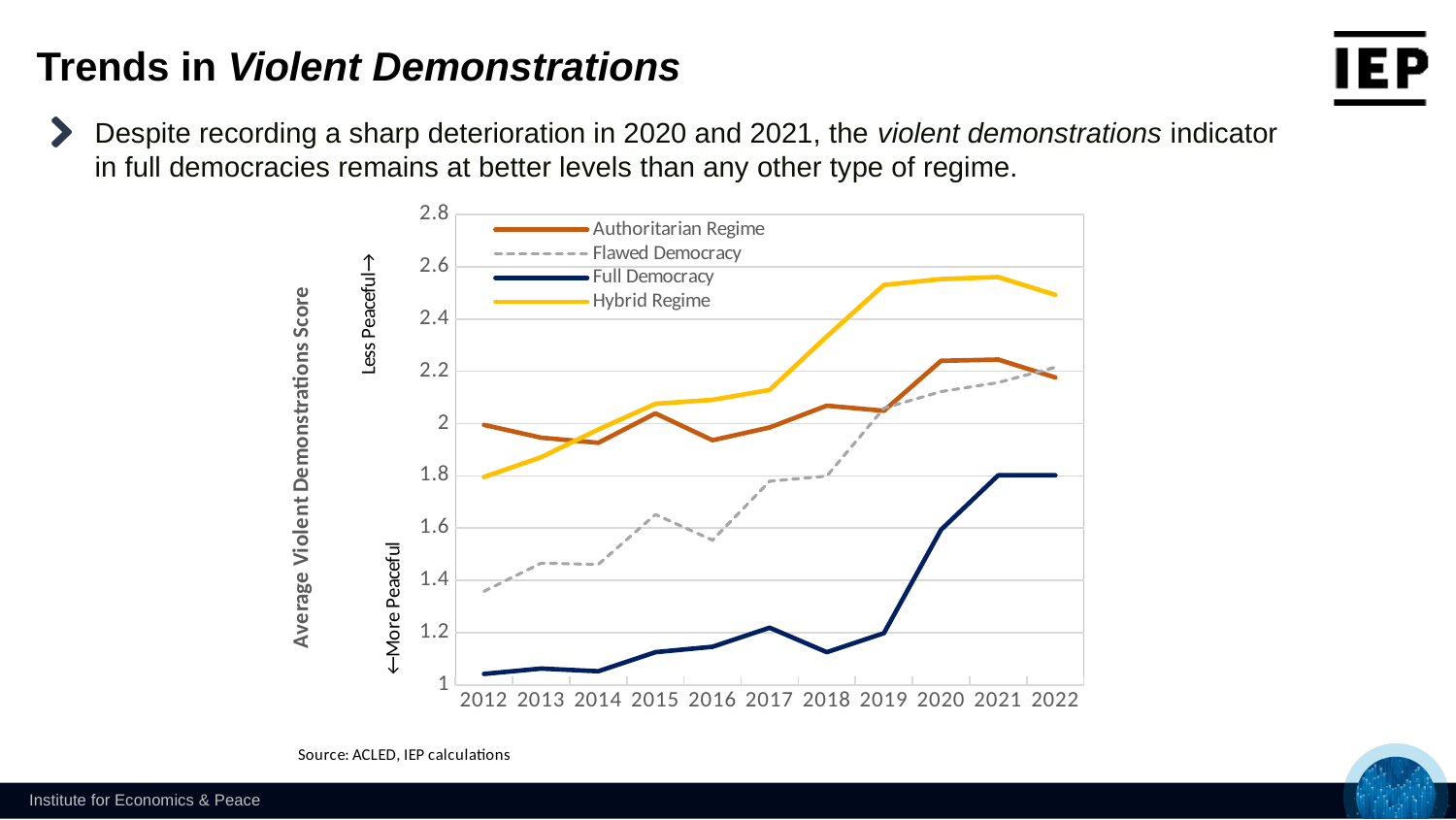
How many series does the legend list? 4 In 2020, which is larger: the value for Authoritarian Regime or the value for Flawed Democracy? Authoritarian Regime What is the title of the y axis? Average Violent Demonstrations Score Is the value for Full Democracy in 2012 greater or less than 1.2? less Which regime type has the lowest violent demonstrations score in 2022? Full Democracy Is the value for Hybrid Regime in 2019 greater or less than 2.4? greater Is the value for Flawed Democracy in 2012 greater or less than 1.6? less Which regime type has the highest violent demonstrations score in 2022? Hybrid Regime Does the Full Democracy line rise or fall from 2012 to 2022? rise Which regime type has the highest violent demonstrations score in 2012? Authoritarian Regime What kind of chart is shown on the slide? line chart How many years are shown along the x axis? 11